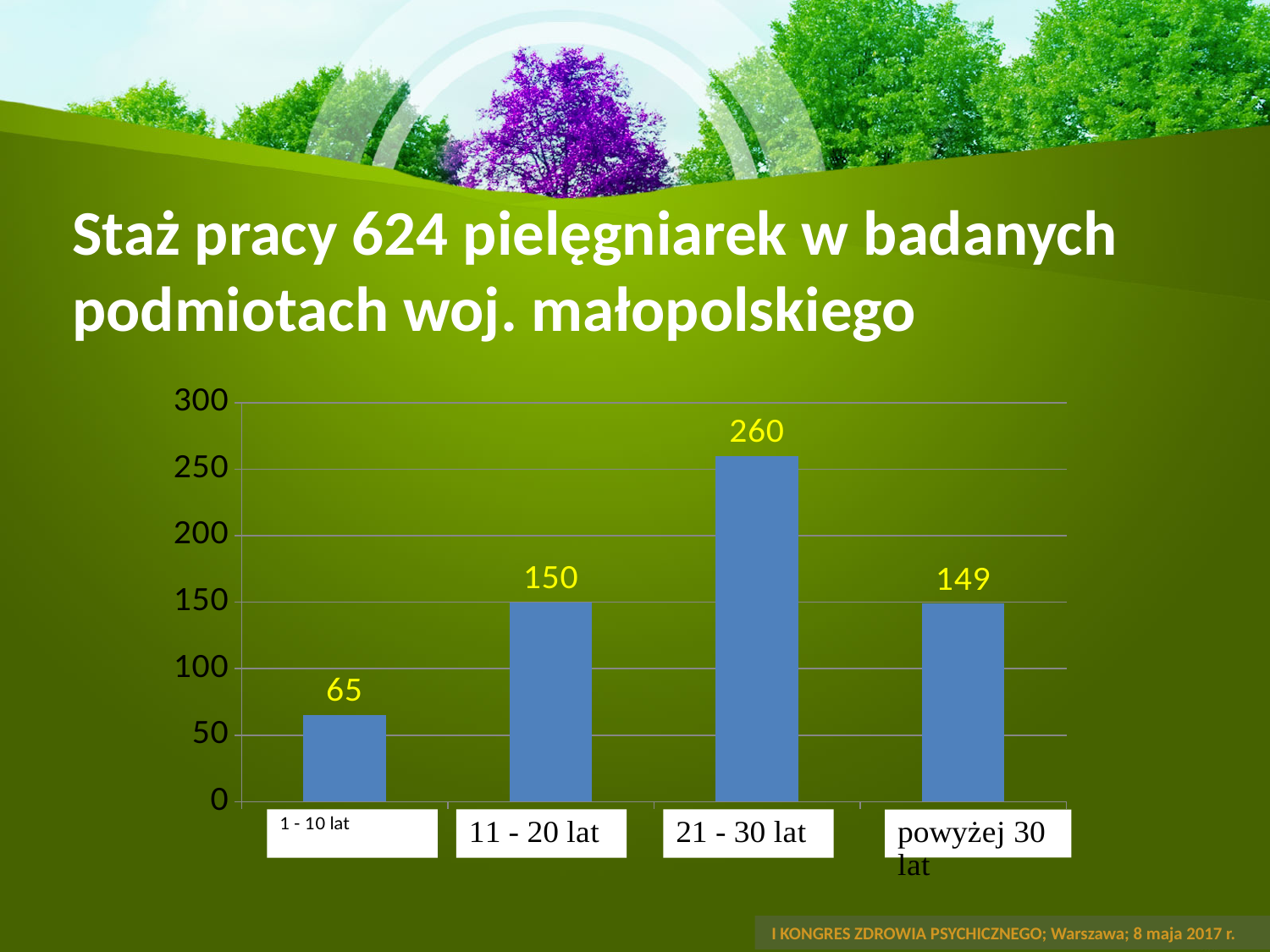
How many categories are shown on the x axis? 4 Which category has the highest value? 21 - 30 lat Is the value for '21 - 30 lat' greater or less than 250? greater What is the difference between the values for '11 - 20 lat' and '1 - 10 lat'? 85 What is the difference between the values for '21 - 30 lat' and '11 - 20 lat'? 110 What is the value for the 'powyżej 30 lat' category? 149 Which category has the lowest value? 1 - 10 lat What kind of chart is shown on the slide? bar chart What is the value for the '1 - 10 lat' category? 65 What is the title of the slide containing the chart? Staż pracy 624 pielęgniarek w badanych podmiotach woj. małopolskiego Which is larger, the value for '21 - 30 lat' or the value for 'powyżej 30 lat'? 21 - 30 lat What is the value for the '21 - 30 lat' category? 260